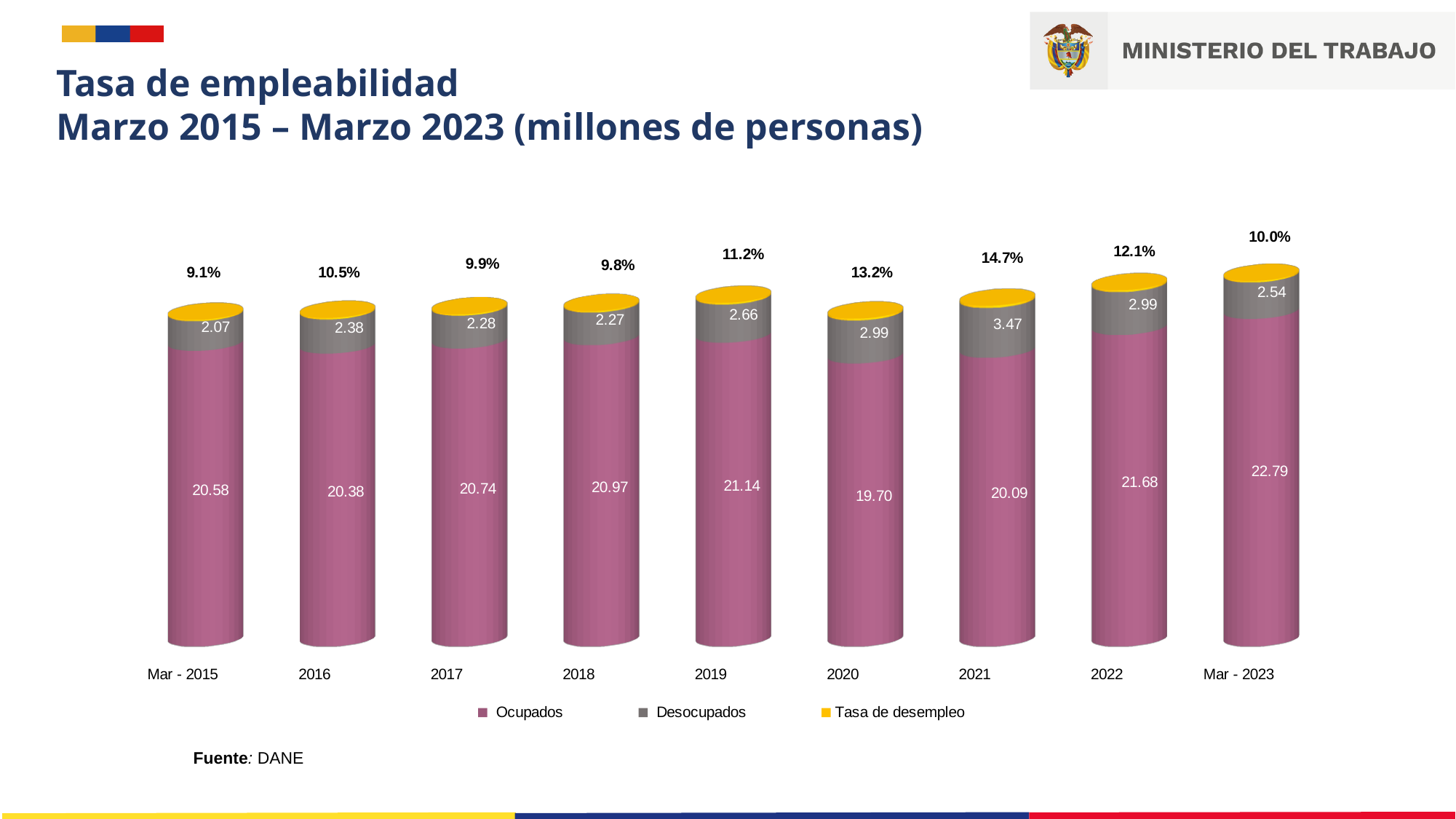
What is the difference between the Ocupados values for 2022 and 2021? 1.59 Which year has the highest Tasa de desempleo? 2021 What is the Tasa de desempleo shown for 2019? 11.2% What kind of chart is shown on the slide? Stacked bar chart How many series does the legend list? 3 Which category has the lowest Desocupados value? Mar - 2015 How many categories are shown on the x axis? 9 Which is larger, the Ocupados value for 2019 or for 2018? 2019 What is the combined total of Ocupados and Desocupados for 2020? 22.69 What is the Ocupados value for 2020? 19.70 Which category has the highest Ocupados value? Mar - 2023 What is the Desocupados value for 2021? 3.47